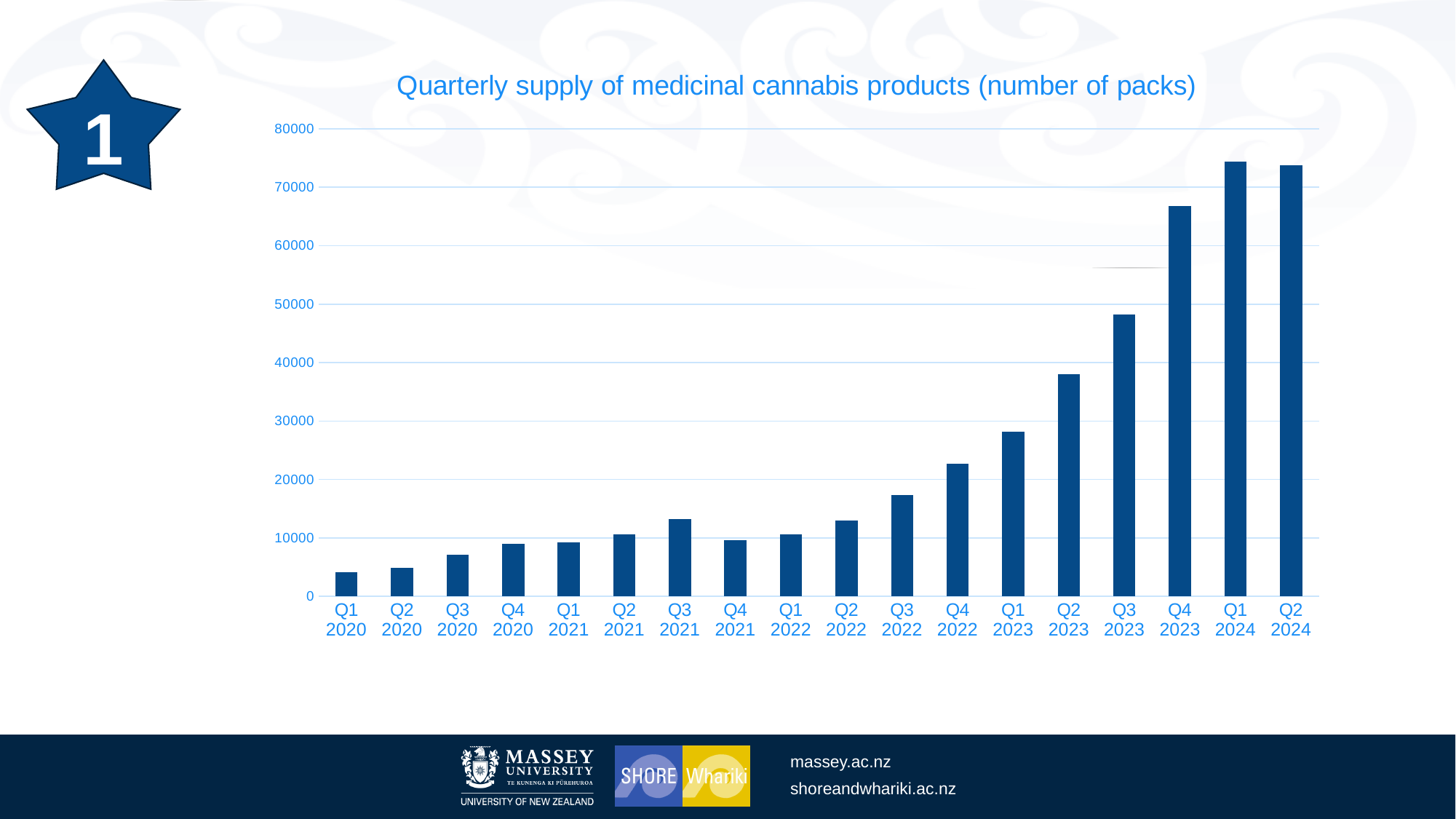
What kind of chart is shown on the slide? Bar chart What is the title of the chart? Quarterly supply of medicinal cannabis products (number of packs) Overall, do the values rise or fall from Q1 2020 to Q2 2024? Rise Is the value for Q3 2023 greater or less than 50000? less Which is larger, the value for Q3 2021 or the value for Q4 2021? Q3 2021 Which is larger, the value for Q2 2023 or the value for Q4 2023? Q4 2023 Is the value for Q1 2023 greater or less than 30000? less Is the value for Q4 2023 greater or less than 60000? greater Which quarter has the lowest supply of medicinal cannabis products? Q1 2020 How many quarters (bars) are plotted on the chart? 18